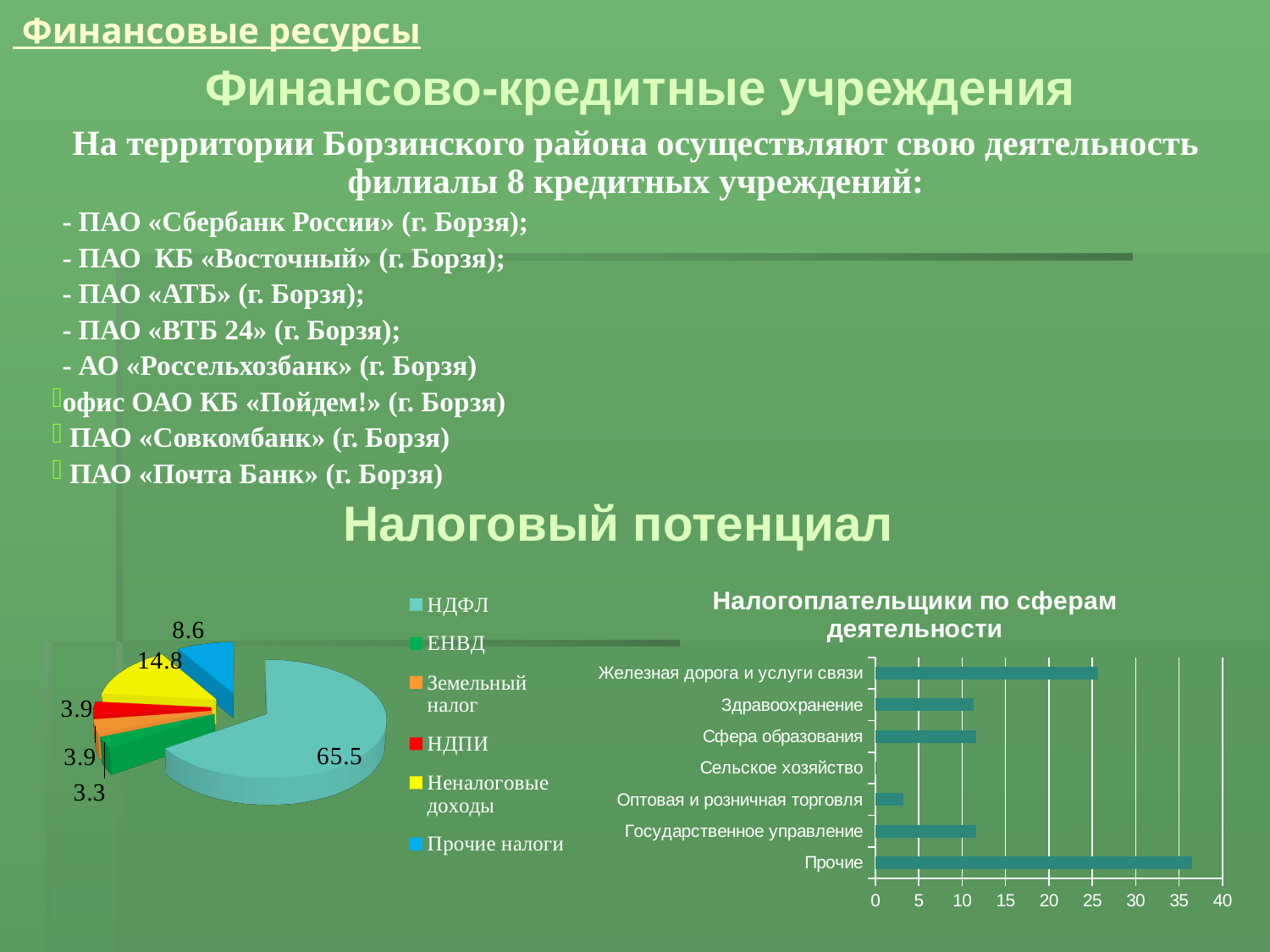
In the chart 'Налогоплательщики по сферам деятельности', is the value for Железная дорога и услуги связи greater or less than 20? greater How many entries does the legend of the pie chart on the left list? 6 In the chart 'Налогоплательщики по сферам деятельности', which category has the lowest value? Сельское хозяйство In the pie chart on the left, what is the difference between the values for НДФЛ and Неналоговые доходы? 50.7 What kind of chart is 'Налогоплательщики по сферам деятельности'? bar chart In the pie chart on the left, what is the value shown for Прочие налоги? 8.6 In the pie chart on the left, which category has the largest slice? НДФЛ How many categories are shown in the chart 'Налогоплательщики по сферам деятельности'? 7 In the pie chart on the left, what is the value shown for НДФЛ? 65.5 In the pie chart on the left, what is the value shown for Неналоговые доходы? 14.8 In the chart 'Налогоплательщики по сферам деятельности', which is larger: Железная дорога и услуги связи or Здравоохранение? Железная дорога и услуги связи In the chart 'Налогоплательщики по сферам деятельности', which category has the highest value? Прочие